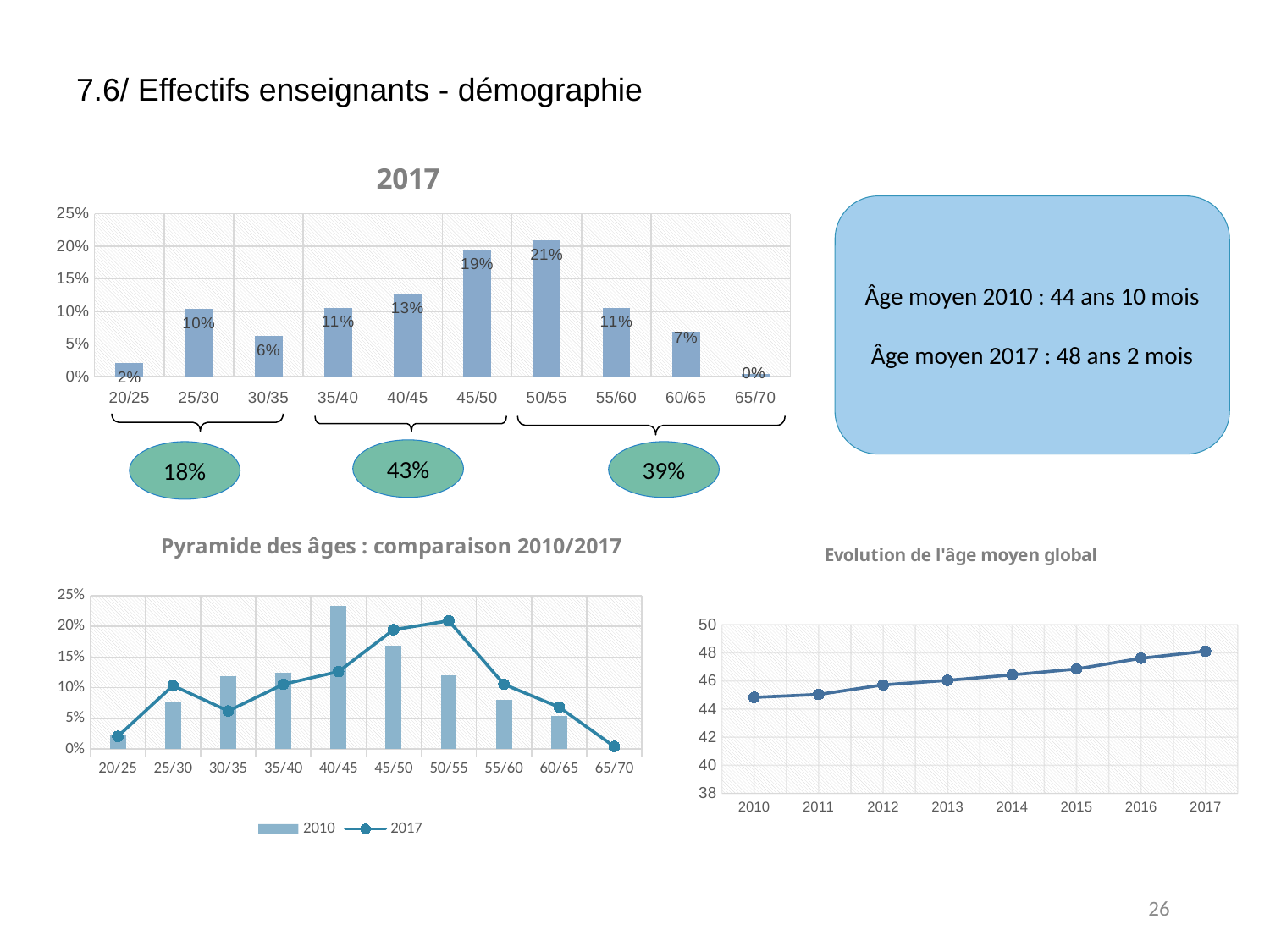
In the chart titled "2017", how many age groups are shown on the x axis? 10 In the chart titled "2017", which is larger, the value for 25/30 or the value for 30/35? 25/30 In the chart titled "Evolution de l'âge moyen global", how many years are shown on the x axis? 8 In the chart titled "2017", which age group has the lowest value? 65/70 In the chart titled "Evolution de l'âge moyen global", do the values rise or fall from 2010 to 2017? rise In the chart titled "Pyramide des âges : comparaison 2010/2017", is the 2010 value for 40/45 greater or less than 20%? greater In the chart titled "2017", what is the value for the 50/55 age group? 21% In the chart titled "2017", what is the value for the 20/25 age group? 2% In the chart titled "Pyramide des âges : comparaison 2010/2017", how many series does the legend list? 2 In the chart titled "2017", which age group has the highest value? 50/55 What kind of chart is the chart titled "Evolution de l'âge moyen global"? line chart In the chart titled "2017", what is the difference between the values for 50/55 and 45/50? 2%